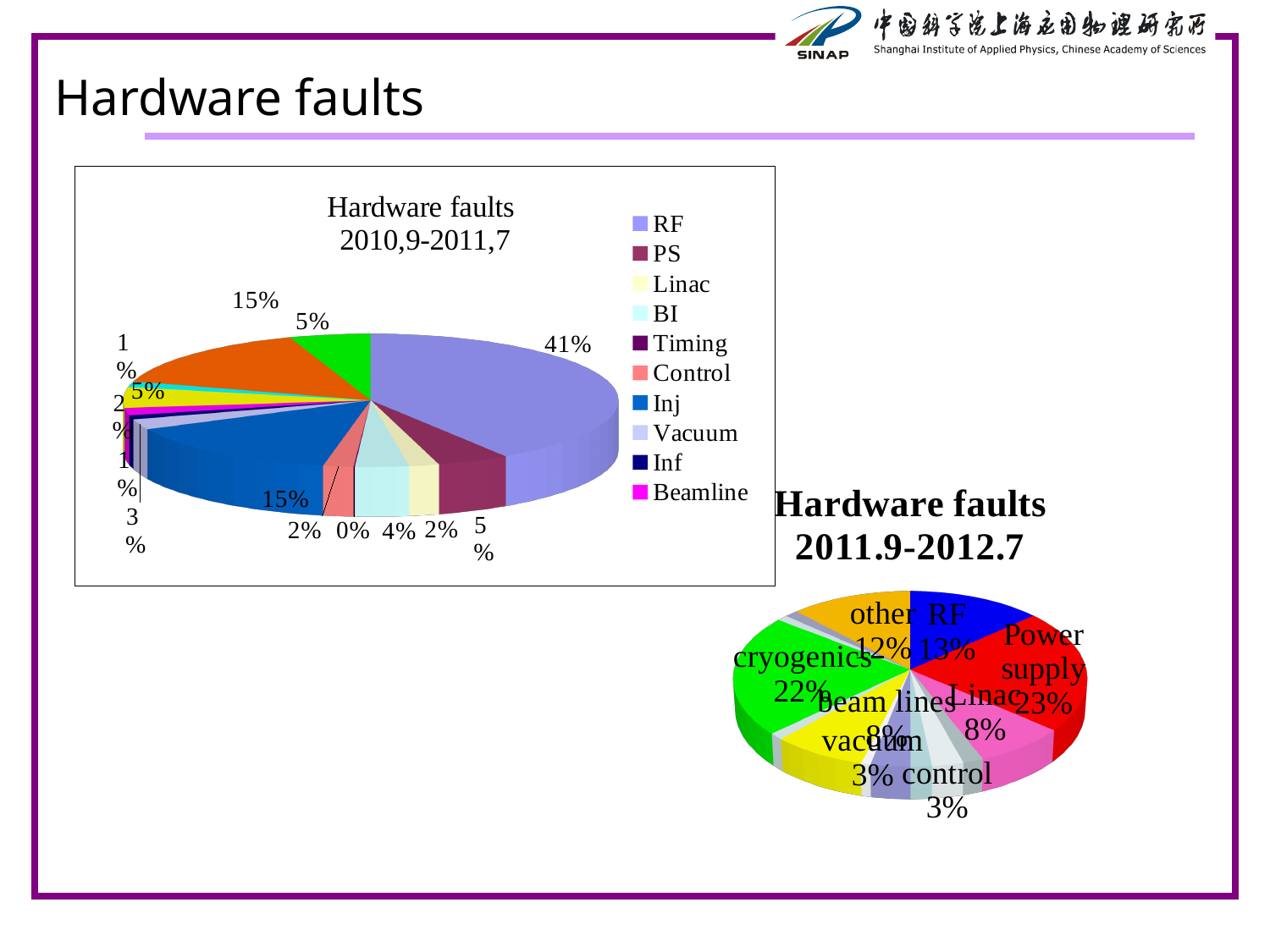
In the 'Hardware faults 2010,9-2011,7' chart, what share is attributed to Timing? 0% In the 'Hardware faults 2011.9-2012.7' chart, what share of faults is attributed to control? 3% In the 'Hardware faults 2010,9-2011,7' chart, what share of faults is attributed to RF? 41% In the 'Hardware faults 2010,9-2011,7' chart, which category has the largest share? RF In the 'Hardware faults 2011.9-2012.7' chart, what is the difference in percentage points between the Power supply share and the Linac share? 15 In the 'Hardware faults 2011.9-2012.7' chart, which is larger, the share for Power supply or the share for cryogenics? Power supply What kind of chart is the 'Hardware faults 2010,9-2011,7' chart? Pie chart How many entries does the legend of the 'Hardware faults 2010,9-2011,7' chart list? 10